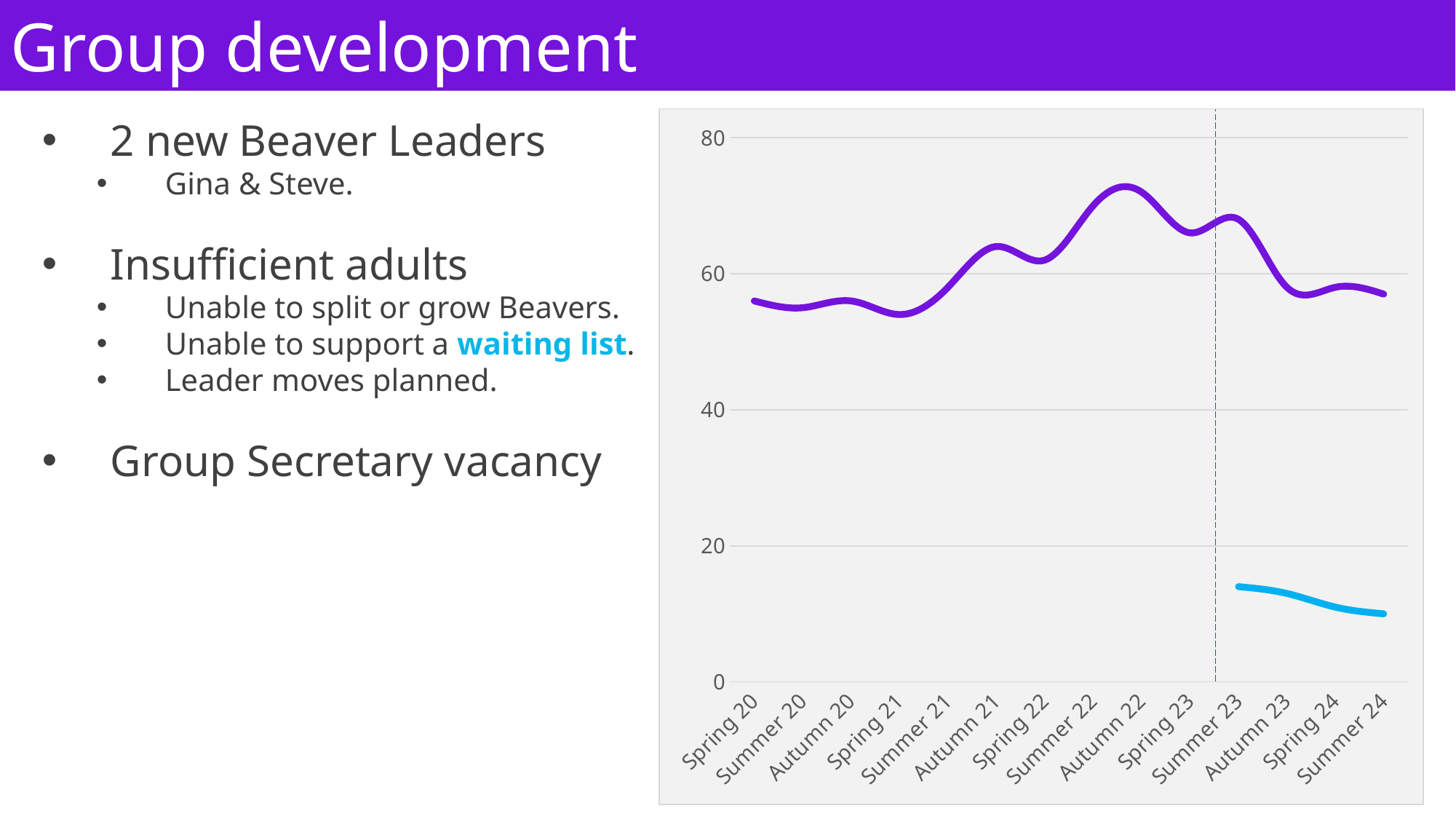
At which x-axis category does the blue line begin? Summer 23 Is the value of the purple line at Autumn 22 greater or less than 60? greater How many categories are shown on the x axis of the chart? 14 At Summer 24, which line has the larger value, the purple line or the blue line? the purple line Does the purple line rise or fall from Autumn 22 to Spring 24? fall What kind of chart is shown on the slide? line chart Is the value of the purple line at Summer 24 greater or less than 40? greater Which category has the highest value on the purple line? Autumn 22 How many lines are plotted on the chart? 2 Does the blue line rise or fall from Summer 23 to Summer 24? fall Is the value of the blue line at Summer 23 greater or less than 20? less